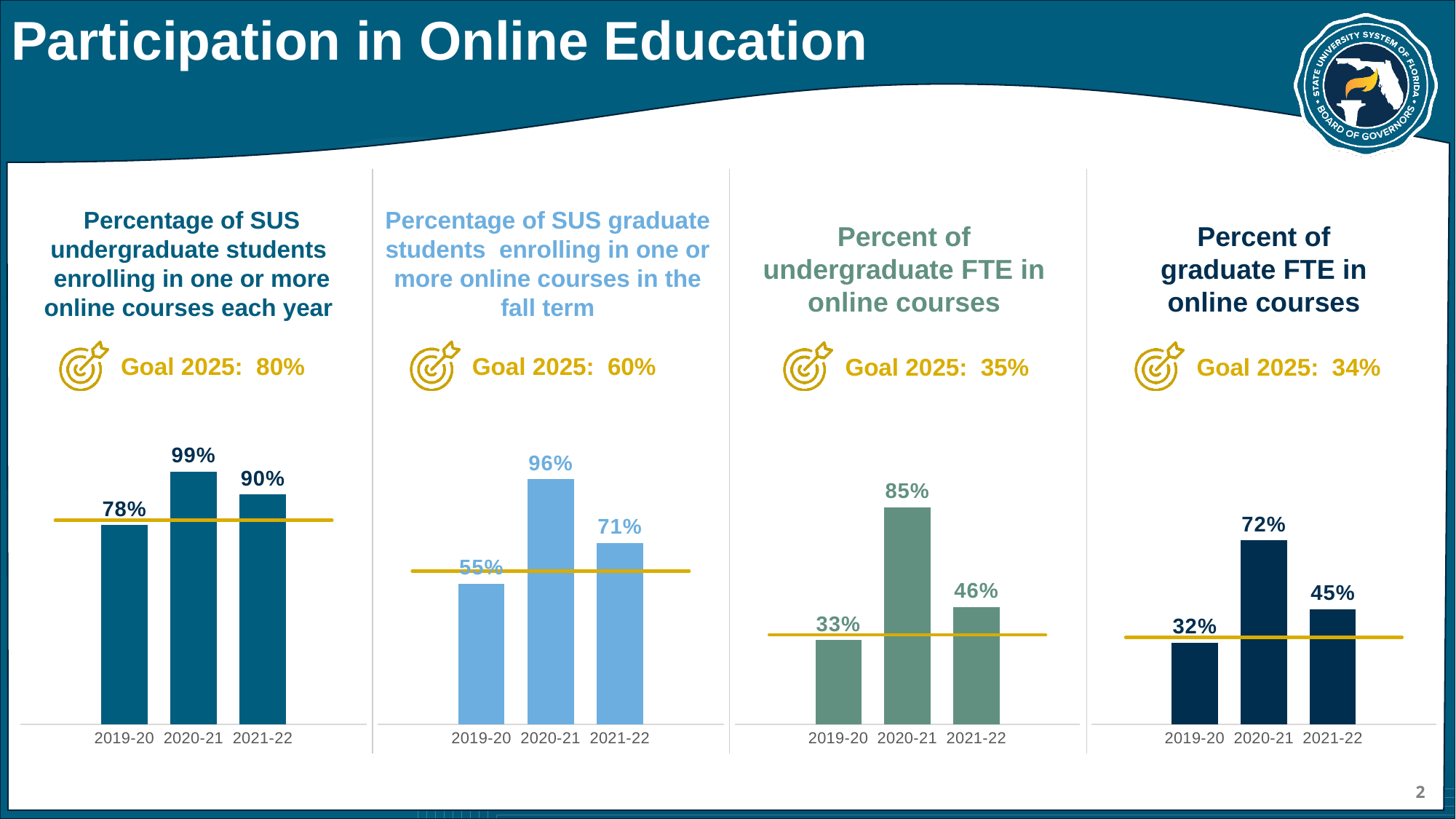
In the third chart from the left (Percent of undergraduate FTE in online courses), what is the value for 2021-22? 46% How many years are shown on the x axis of the rightmost chart (Percent of graduate FTE in online courses)? 3 In the leftmost chart (Percentage of SUS undergraduate students enrolling in one or more online courses each year), what is the value for 2020-21? 99% In the second chart from the left (Percentage of SUS graduate students enrolling in one or more online courses in the fall term), what is the value for 2019-20? 55% In the leftmost chart (Percentage of SUS undergraduate students enrolling in one or more online courses each year), which year has the lowest value? 2019-20 In the third chart from the left (Percent of undergraduate FTE in online courses), which is larger, the value for 2019-20 or the value for 2021-22? 2021-22 What kind of chart is the leftmost chart (Percentage of SUS undergraduate students enrolling in one or more online courses each year)? bar chart In the rightmost chart (Percent of graduate FTE in online courses), what is the difference between the 2020-21 and 2019-20 values? 40% In the second chart from the left (Percentage of SUS graduate students enrolling in one or more online courses in the fall term), what is the difference between the 2020-21 and 2021-22 values? 25% In the rightmost chart (Percent of graduate FTE in online courses), which year has the highest value? 2020-21 What is the Goal 2025 shown for the second chart from the left (Percentage of SUS graduate students enrolling in one or more online courses in the fall term)? 60% What is the Goal 2025 shown for the third chart from the left (Percent of undergraduate FTE in online courses)? 35%